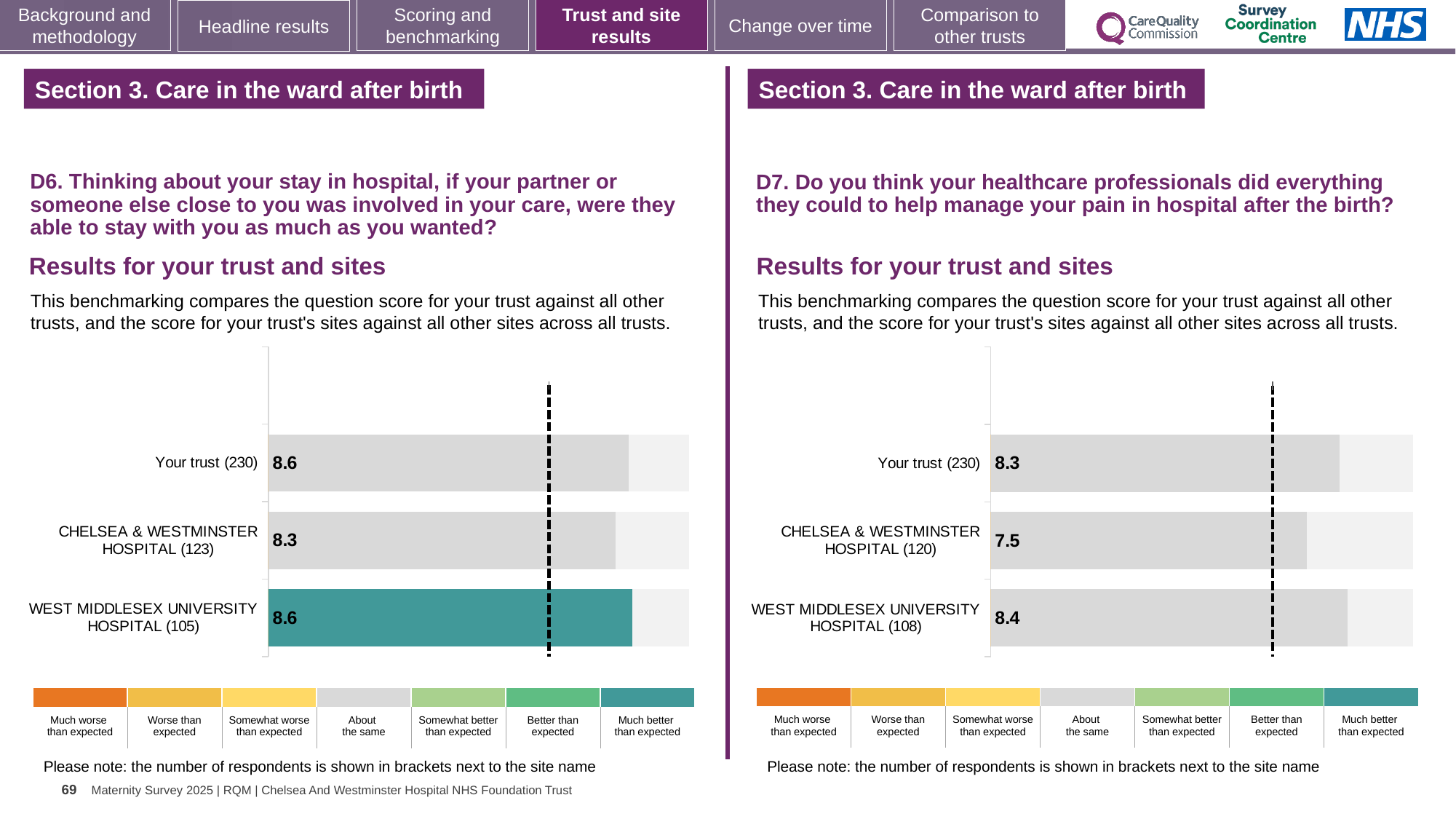
In the D6 chart on the left, what is the difference between the scores for Your trust (230) and CHELSEA & WESTMINSTER HOSPITAL (123)? 0.3 In the D7 chart on the right, which bar has the highest score? WEST MIDDLESEX UNIVERSITY HOSPITAL (108) In the D6 chart on the left, what is the score for Your trust (230)? 8.6 In the D6 chart on the left, which site has the lowest score? CHELSEA & WESTMINSTER HOSPITAL (123) In the D7 chart on the right, which bar has the lowest score? CHELSEA & WESTMINSTER HOSPITAL (120) In the D7 chart on the right, which has the larger score: Your trust (230) or CHELSEA & WESTMINSTER HOSPITAL (120)? Your trust (230) How many bars are shown in the D6 chart on the left? 3 In the D6 chart on the left, what is the score for CHELSEA & WESTMINSTER HOSPITAL (123)? 8.3 In the D7 chart on the right, what is the difference between the scores for Your trust (230) and CHELSEA & WESTMINSTER HOSPITAL (120)? 0.8 In the D6 chart on the left, which benchmark category does the colour of the WEST MIDDLESEX UNIVERSITY HOSPITAL (105) bar correspond to? Much better than expected In the D7 chart on the right, what is the score for WEST MIDDLESEX UNIVERSITY HOSPITAL (108)? 8.4 In the D7 chart on the right, what is the score for CHELSEA & WESTMINSTER HOSPITAL (120)? 7.5